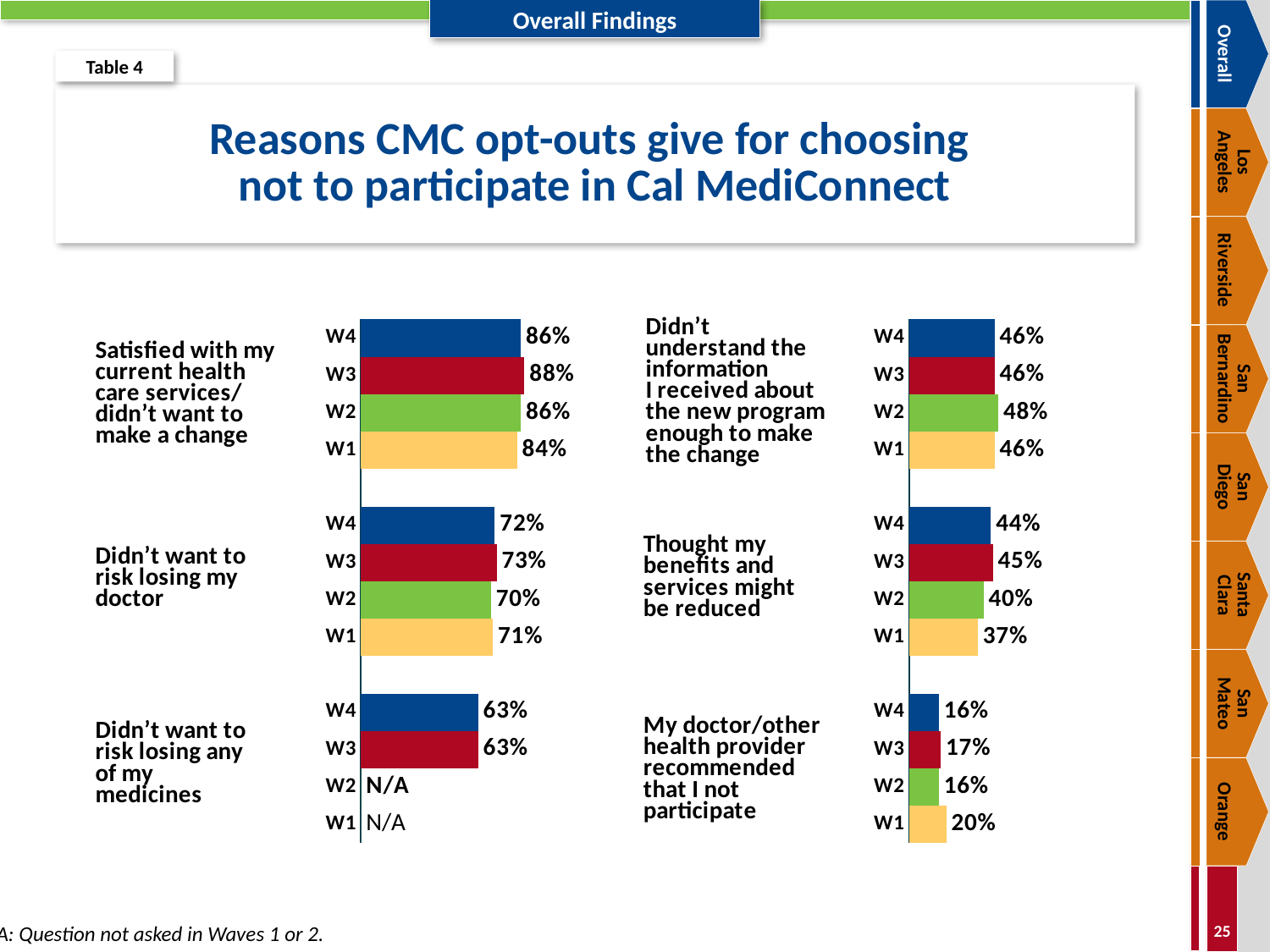
What kind of chart is used on this slide? bar chart In the 'Satisfied with my current health care services/didn't want to make a change' chart, what is the difference between the W3 and W1 values? 4% In the 'My doctor/other health provider recommended that I not participate' chart, which wave has the highest value? W1 In the 'Satisfied with my current health care services/didn't want to make a change' chart, what is the value for W3? 88% In the 'Didn't want to risk losing any of my medicines' chart, what is shown for W2? N/A In the 'Thought my benefits and services might be reduced' chart, what is the difference between the W4 and W1 values? 7% In the 'Thought my benefits and services might be reduced' chart, do the values rise or fall from W1 to W4? rise In the 'Thought my benefits and services might be reduced' chart, which wave has the lowest value? W1 In the 'Didn't understand the information I received about the new program enough to make the change' chart, which wave has the highest value? W2 In the 'Didn't want to risk losing my doctor' chart, what is the value for W2? 70% In the 'Didn't want to risk losing my doctor' chart, which is larger, the W3 value or the W2 value? W3 In the 'Thought my benefits and services might be reduced' chart, what is the value for W1? 37%